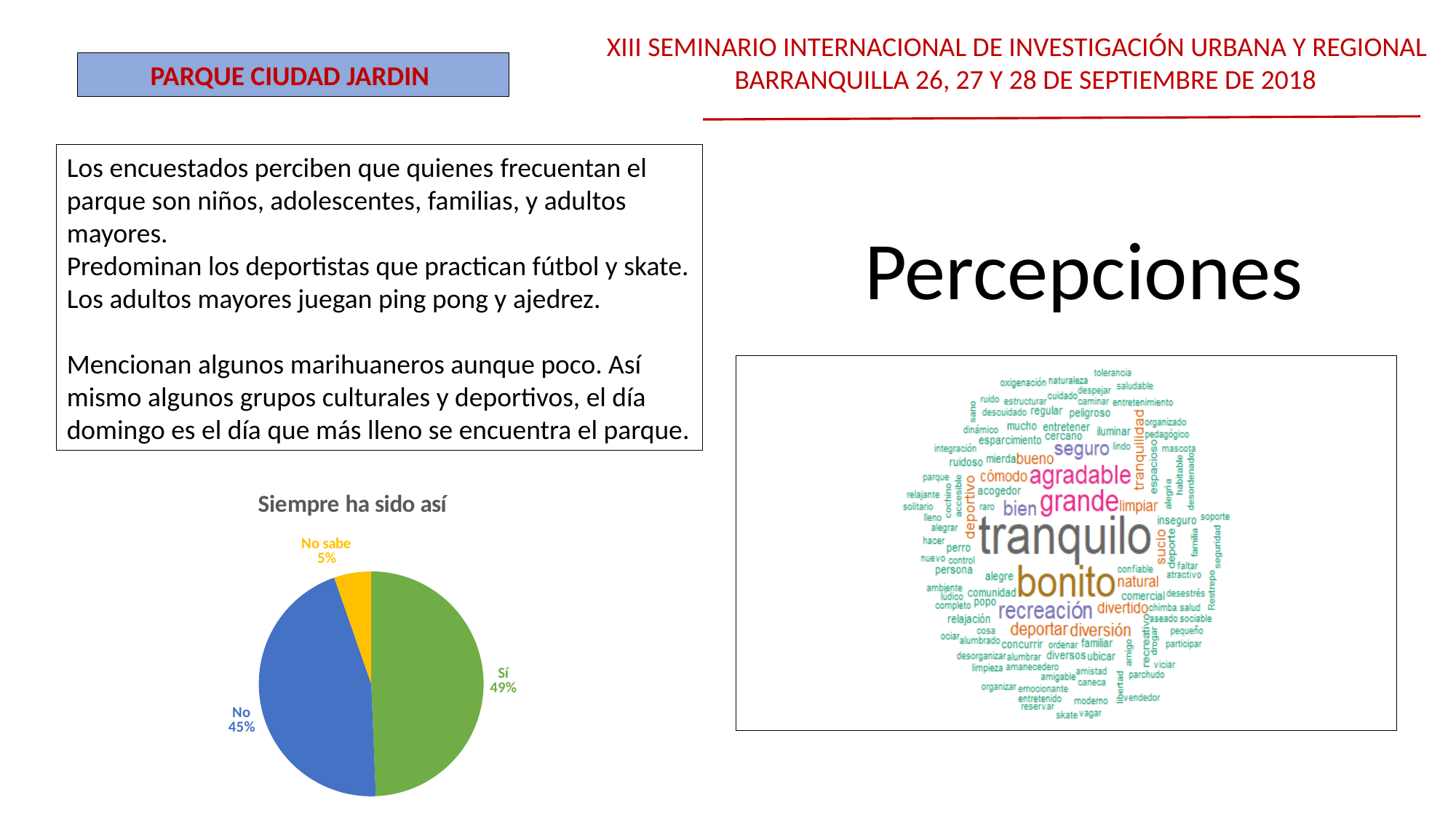
In the pie chart 'Siempre ha sido así', which category has the smallest share? No sabe In the pie chart 'Siempre ha sido así', what is the difference between the 'No' and 'No sabe' shares? 40% What is the title of the pie chart on the slide? Siempre ha sido así In the pie chart 'Siempre ha sido así', what share is labelled 'Sí'? 49% In the pie chart 'Siempre ha sido así', how many slices are there? 3 In the pie chart 'Siempre ha sido así', which category has the largest share? Sí In the pie chart 'Siempre ha sido así', what colour is the 'No sabe' slice? yellow In the pie chart 'Siempre ha sido así', what is the difference between the 'Sí' and 'No' shares? 4% What kind of chart is 'Siempre ha sido así'? pie chart In the pie chart 'Siempre ha sido así', what share is labelled 'No'? 45% In the pie chart 'Siempre ha sido así', what share is labelled 'No sabe'? 5% In the pie chart 'Siempre ha sido así', which is larger, 'No' or 'No sabe'? No